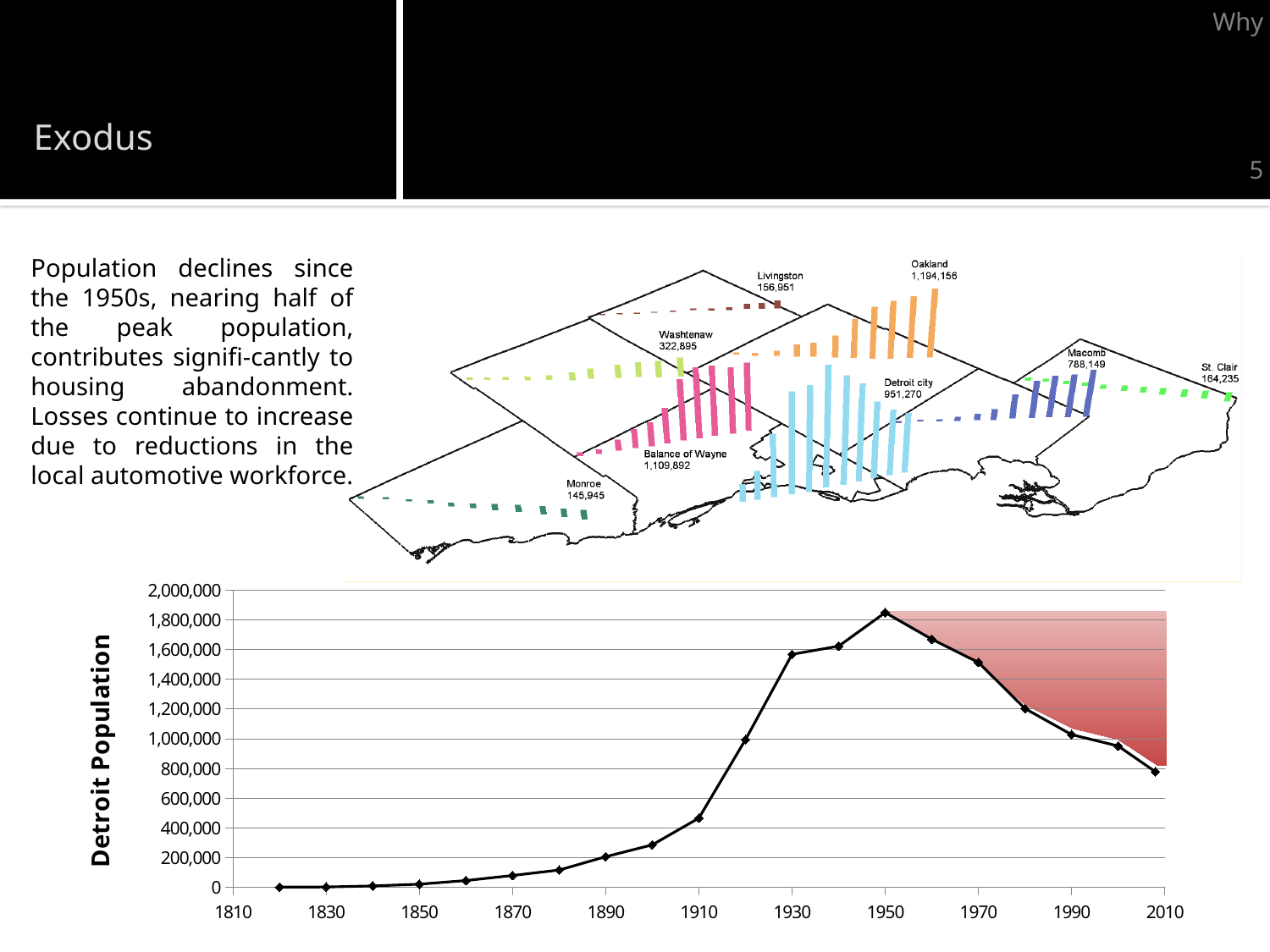
On the map chart at the top of the slide, what population value is printed for Oakland? 1,194,156 In the bottom line chart, which is larger, the Detroit population in 1970 or in 1990? 1970 On the map chart at the top of the slide, what population value is printed for Macomb? 788,149 In the bottom line chart, is the Detroit population in 1930 greater or less than 1,400,000? greater In the bottom line chart, is the Detroit population in 1950 greater or less than 1,600,000? greater In the bottom line chart, which year has the highest Detroit population? 1950 In the bottom line chart, does the Detroit population rise or fall between 1950 and 2010? fall What kind of chart is the chart at the bottom of the slide? line chart In the bottom line chart, is the Detroit population in 1910 greater or less than 600,000? less On the map chart at the top of the slide, what is the difference between the printed values for Oakland and Detroit city? 242,886 What is the title of the vertical axis of the bottom line chart? Detroit Population